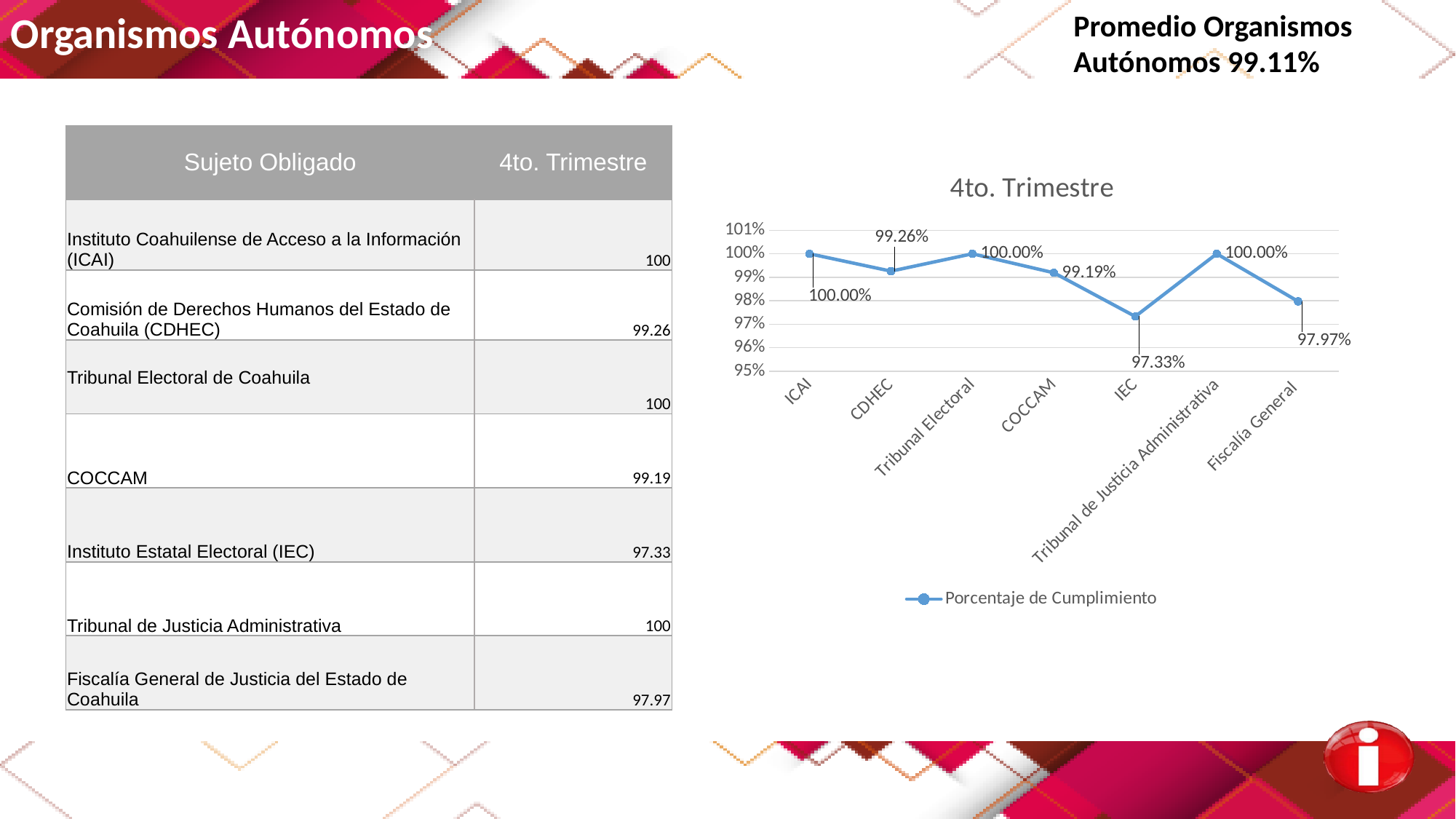
What is the difference between the values for CDHEC and Fiscalía General? 1.29% Which category has the lowest value in the chart? IEC What kind of chart is shown on the slide? line chart What series name does the chart legend show? Porcentaje de Cumplimiento Is the value for IEC greater or less than 98%? less How many categories are plotted in the chart? 7 Which is larger, the value for COCCAM or the value for Fiscalía General? COCCAM What is the value for COCCAM in the chart? 99.19% What is the difference between the values for ICAI and IEC? 2.67% What is the value for Fiscalía General in the chart? 97.97% What is the value for CDHEC in the chart? 99.26% What is the value for IEC in the chart? 97.33%